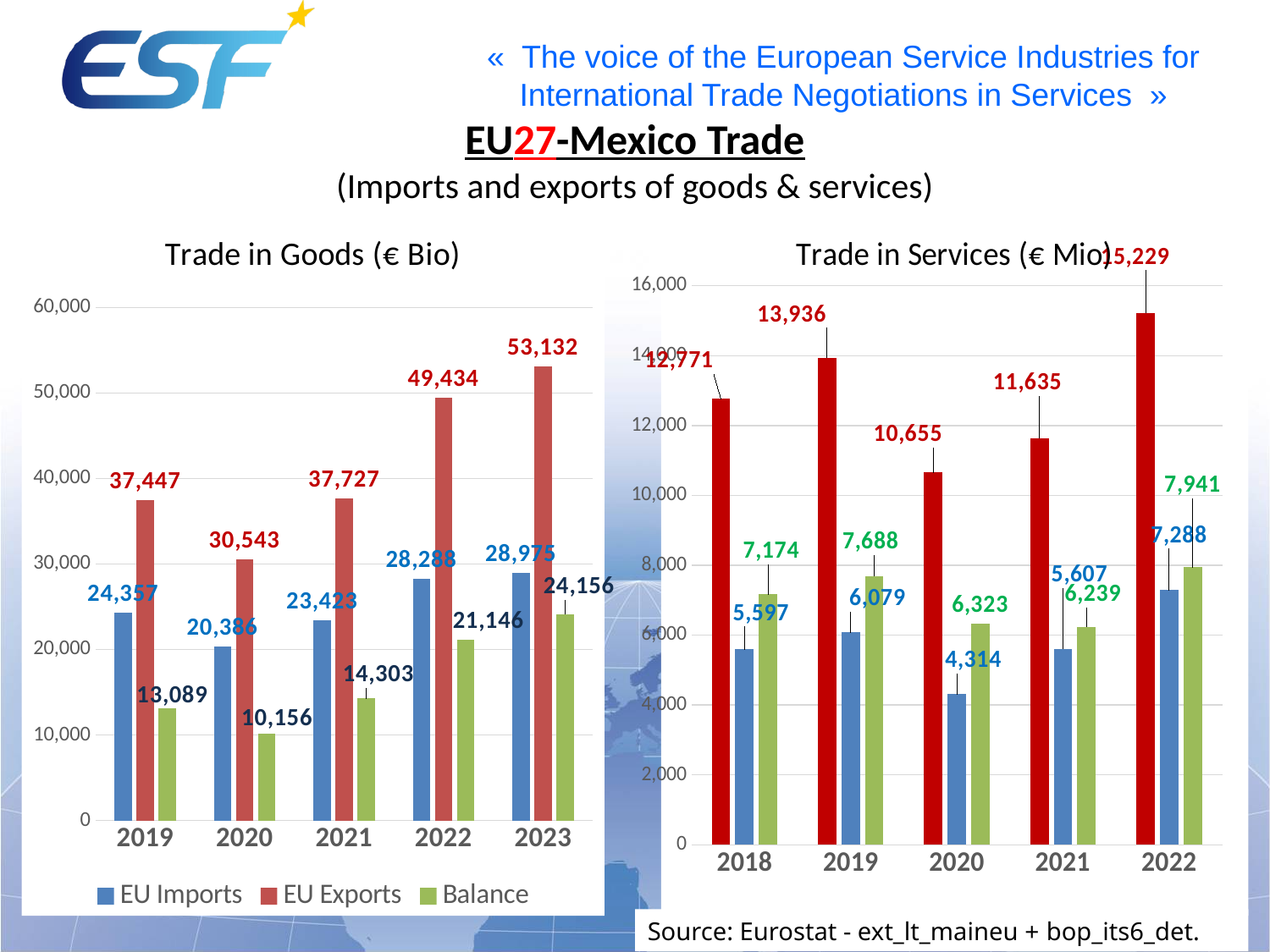
In the Trade in Services chart, which year has the highest red bar? 2022 In the Trade in Goods chart, what is the difference between EU Exports and EU Imports in 2022? 21,146 In the Trade in Goods chart, which year has the lowest Balance? 2020 In the Trade in Services chart, is the green bar for 2021 larger or smaller than the green bar for 2019? smaller In the Trade in Goods chart, how many series does the legend list? 3 In the Trade in Goods chart, what is the value of EU Exports in 2023? 53,132 In the Trade in Services chart, what is the value of the red bar in 2019? 13,936 In the Trade in Services chart, what is the value of the blue bar in 2020? 4,314 What type of chart is the Trade in Goods chart? bar chart In the Trade in Goods chart, what is the value of EU Imports in 2020? 20,386 In the Trade in Goods chart, do the EU Exports values rise or fall from 2021 to 2023? rise In the Trade in Services chart, how many years are shown on the x axis? 5